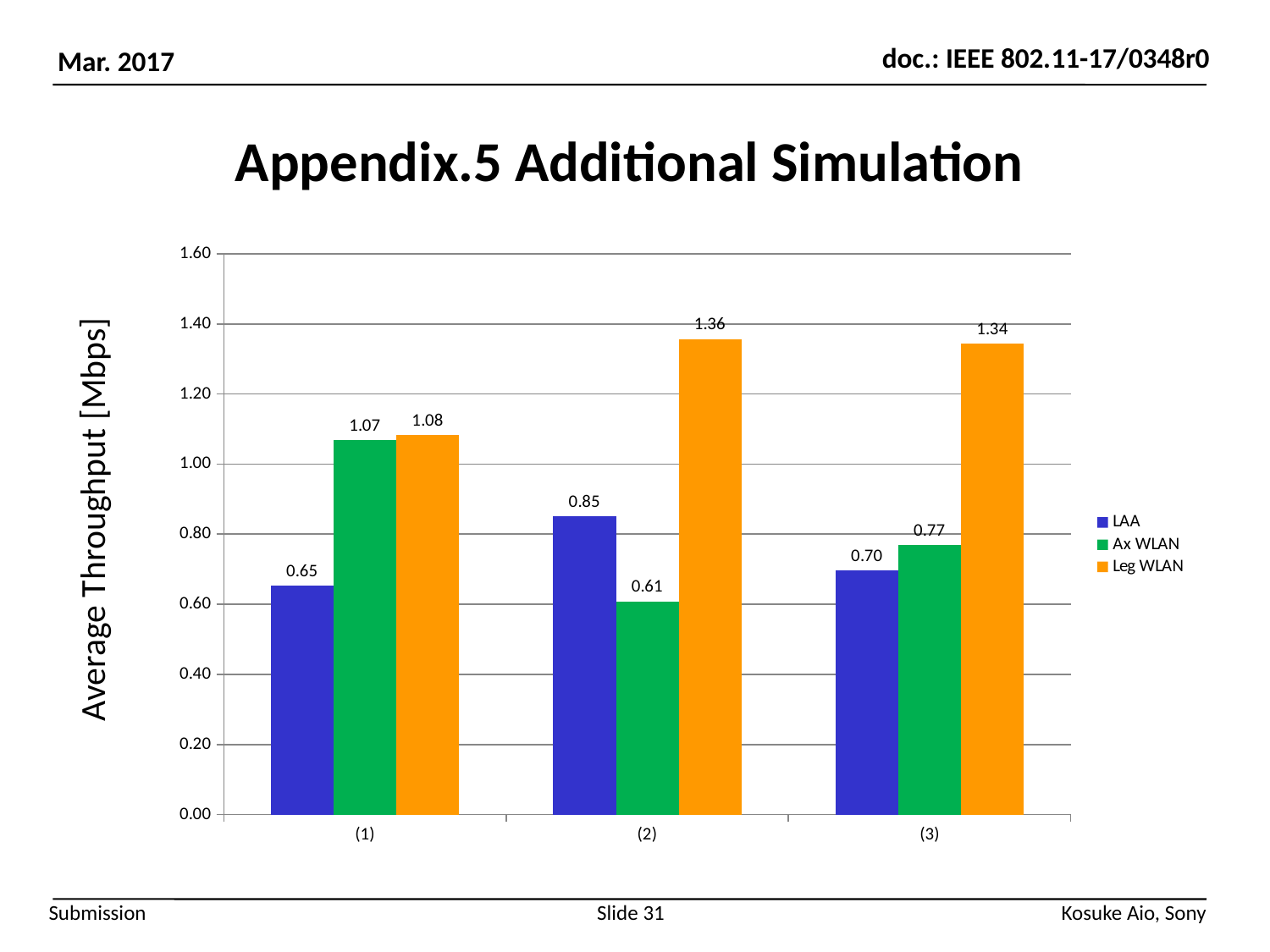
What is the average throughput for Leg WLAN in scenario (2)? 1.36 How many scenarios are shown on the x axis? 3 What kind of chart is shown on the slide? bar chart What is the difference between the Leg WLAN and Ax WLAN values in scenario (2)? 0.75 What is the average throughput for Ax WLAN in scenario (3)? 0.77 How many series does the legend list? 3 What is the average throughput for LAA in scenario (1)? 0.65 Which scenario has the highest LAA throughput? (2) Which is larger in scenario (3), LAA or Leg WLAN? Leg WLAN What is the label of the y axis? Average Throughput [Mbps] Which series has the lowest value in scenario (2)? Ax WLAN Is the Leg WLAN value in scenario (1) greater or less than 1.00? greater